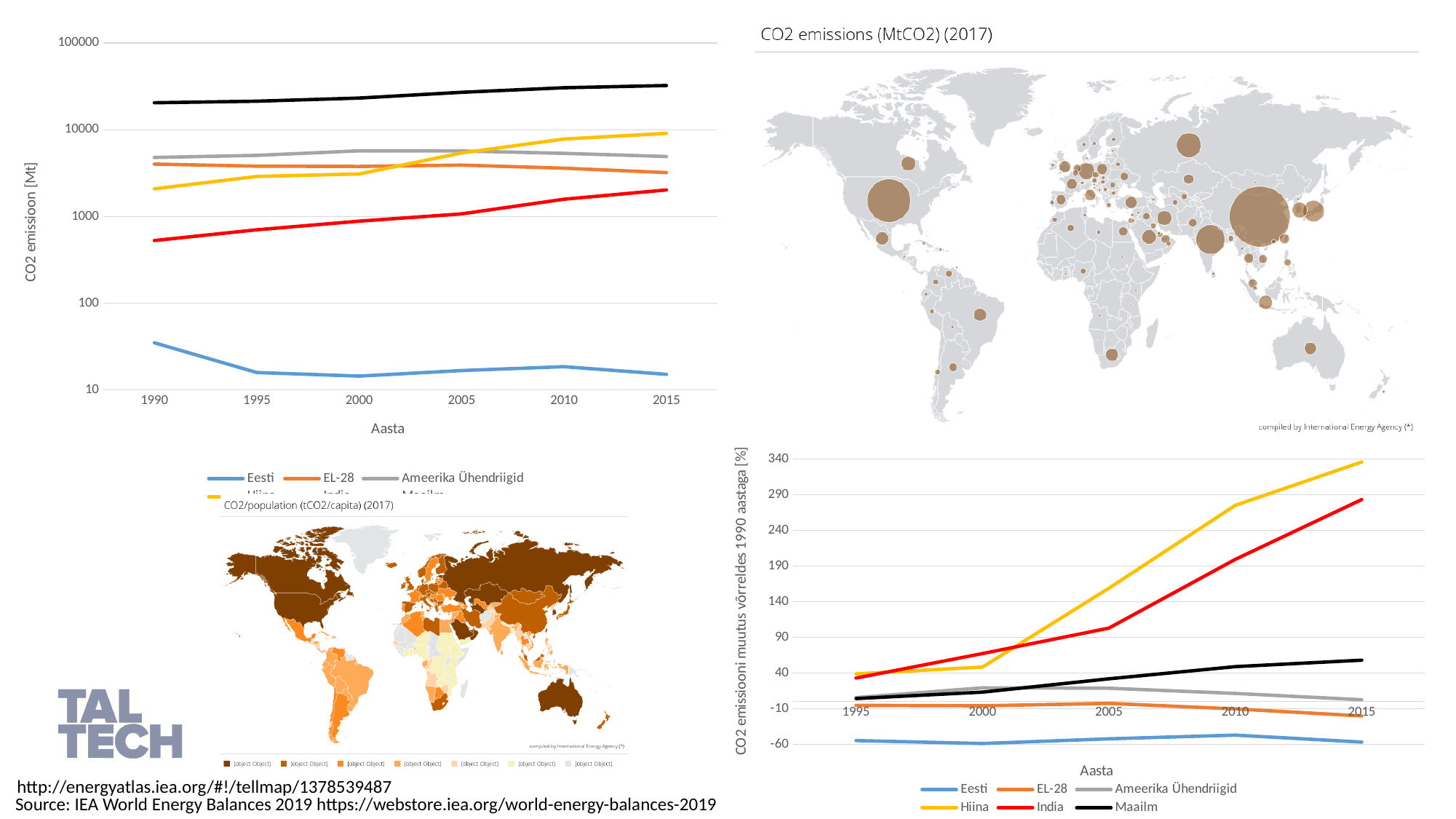
In the top-left chart (CO2 emissioon [Mt]), is the value for Eesti in 1990 greater or less than 100? less In the top-left chart (CO2 emissioon [Mt]), which series has the highest values across all years? Maailm What kind of chart is the top-left chart with the y axis 'CO2 emissioon [Mt]'? line chart How many series does the legend of the bottom-right chart (CO2 emissiooni muutus võrreldes 1990 aastaga [%]) list? 6 In the top-left chart (CO2 emissioon [Mt]), which is larger in 1990: Hiina or Ameerika Ühendriigid? Ameerika Ühendriigid How many years are shown on the x axis of the top-left chart (CO2 emissioon [Mt])? 6 In the top-left chart (CO2 emissioon [Mt]), which is larger in 2015: Hiina or Ameerika Ühendriigid? Hiina In the top-left chart (CO2 emissioon [Mt]), which series has the lowest values across all years? Eesti In the top-left chart (CO2 emissioon [Mt]), is the value for India in 2015 greater or less than 1000? greater In the bottom-right chart (CO2 emissiooni muutus võrreldes 1990 aastaga [%]), is the value for Eesti in 2015 greater or less than -10? less In the top-left chart (CO2 emissioon [Mt]), does the India line rise or fall from 1990 to 2015? rise In the bottom-right chart (CO2 emissiooni muutus võrreldes 1990 aastaga [%]), which series has the highest value in 2015? Hiina